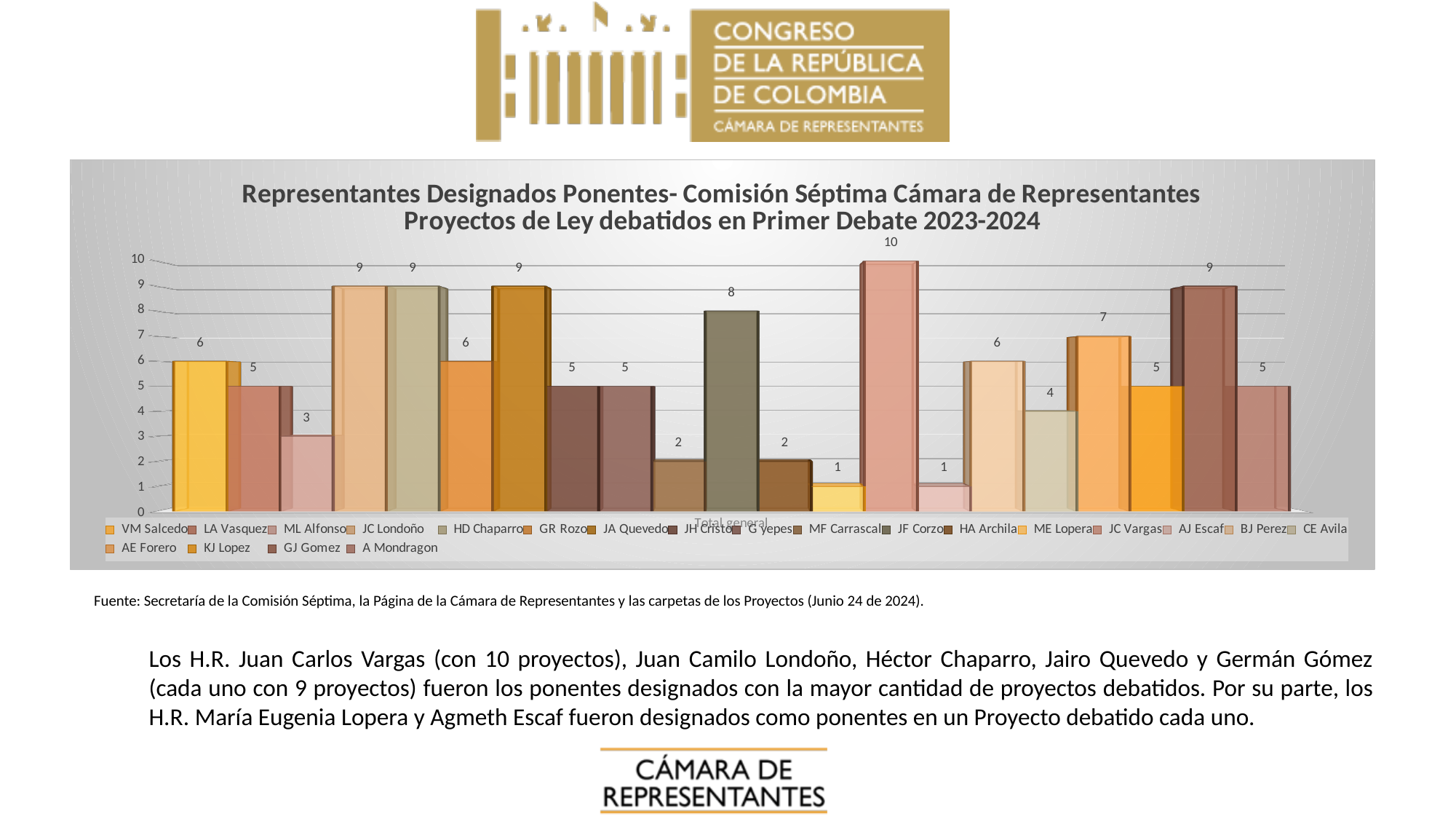
What is the label of the single category on the x axis? Total general What is the value for JF Corzo? 8 What type of chart is shown on the slide? bar chart Which is larger, the value for CE Avila or the value for AE Forero? AE Forero What is the value for AE Forero? 7 Which series has the highest value? JC Vargas What is the value for JC Vargas? 10 What is the difference between the values for JC Londoño and VM Salcedo? 3 What is the difference between the values for JC Vargas and JF Corzo? 2 How many series does the legend list? 21 What is the title of the chart? Representantes Designados Ponentes- Comisión Séptima Cámara de Representantes Proyectos de Ley debatidos en Primer Debate 2023-2024 What is the value for ML Alfonso? 3